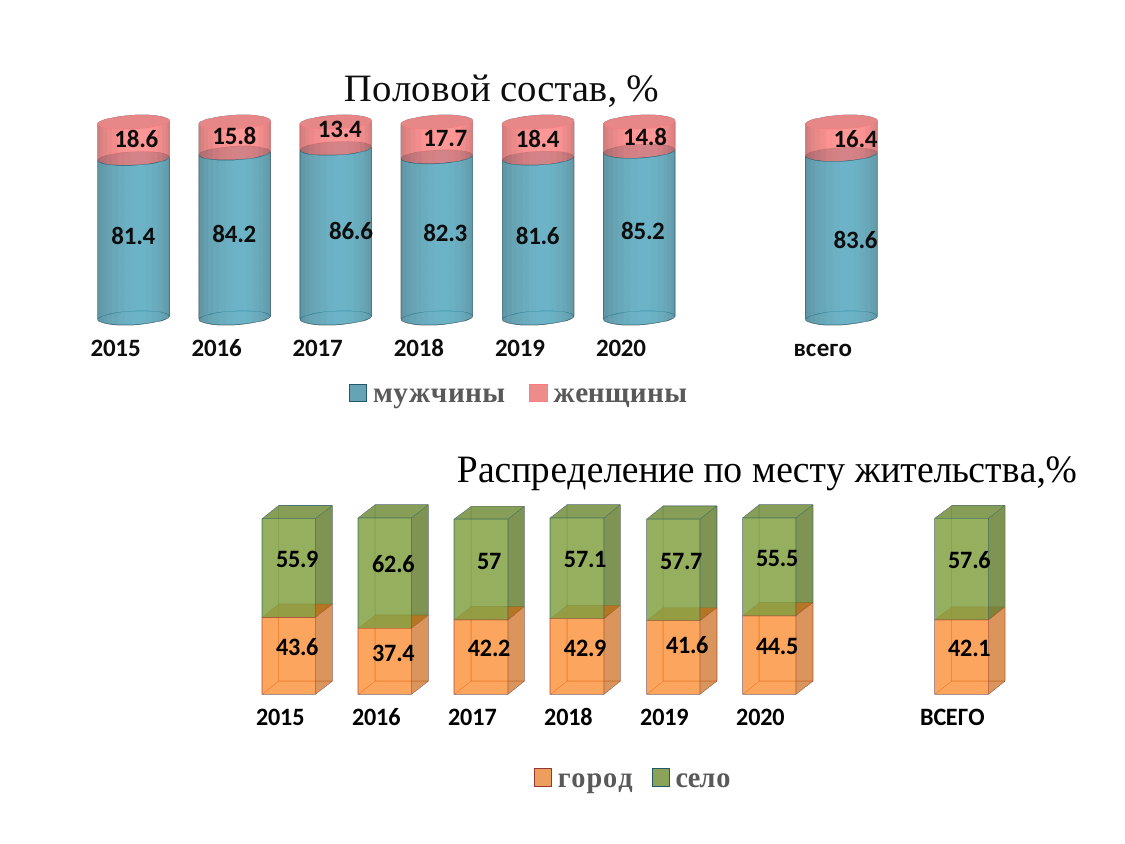
In the chart 'Половой состав, %', what is the value for женщины in 2019? 18.4 In the chart 'Половой состав, %', in which year is the share of мужчины the highest? 2017 In the chart 'Половой состав, %', how many series does the legend list? 2 In the chart 'Половой состав, %', what is the value for мужчины in 2017? 86.6 In the chart 'Половой состав, %', what is the difference between the мужчины values for 2016 and 2015? 2.8 In the chart 'Распределение по месту жительства,%', what is the value for село for ВСЕГО? 57.6 In the chart 'Половой состав, %', in which year is the share of женщины the lowest? 2017 What kind of chart is 'Распределение по месту жительства,%'? Stacked bar chart In the chart 'Распределение по месту жительства,%', in which year is the share of село the highest? 2016 In the chart 'Распределение по месту жительства,%', which is larger: the город value for 2020 or for 2019? 2020 In the chart 'Половой состав, %', how many categories are shown on the x axis? 7 In the chart 'Распределение по месту жительства,%', what is the value for город in 2016? 37.4